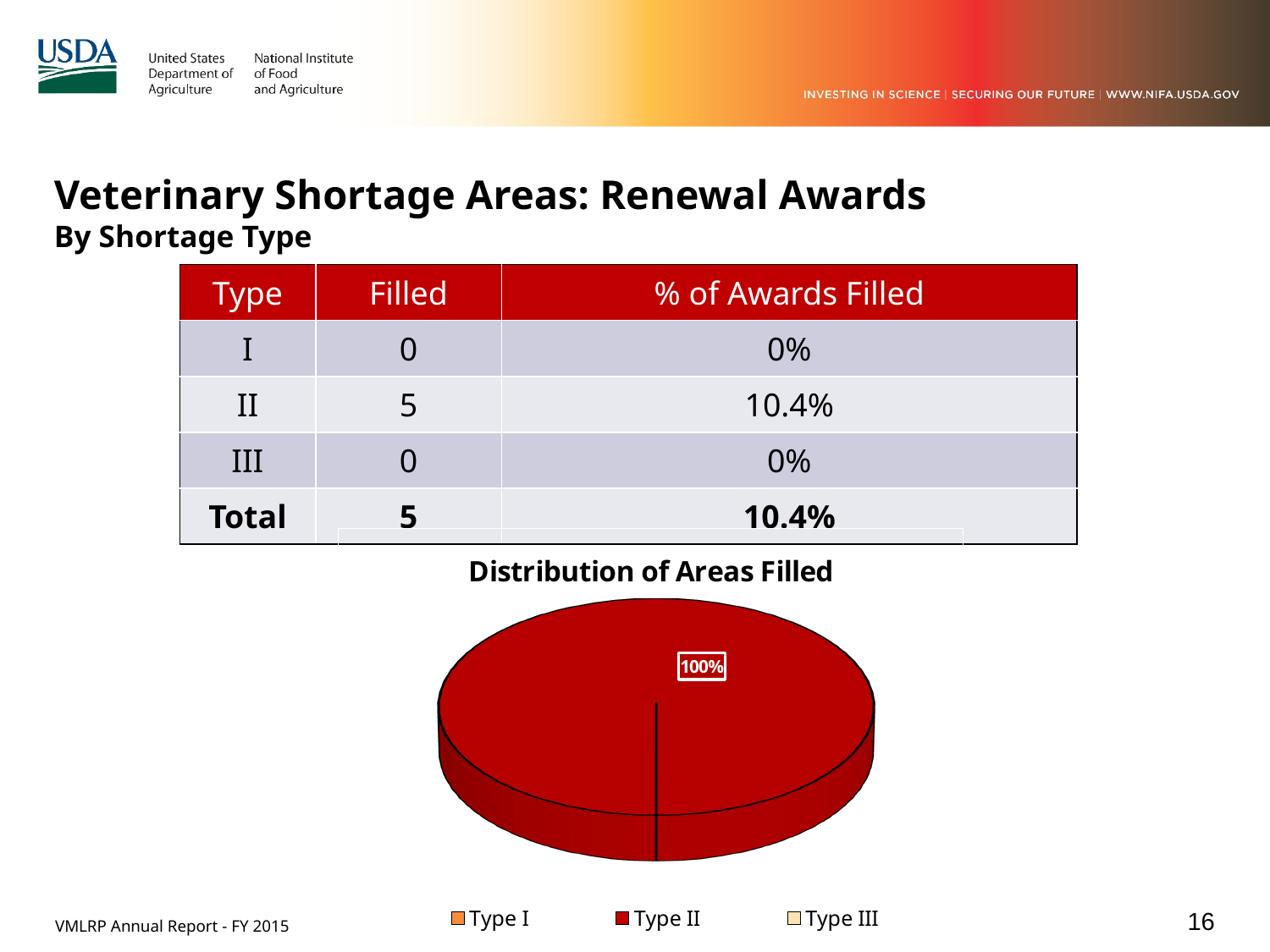
How many entries does the legend of the pie chart list? 3 What colour is the Type II slice in the pie chart? red What share of the pie chart does the labelled slice represent? 100% Which is larger in the pie chart, the share for Type II or the share for Type I? Type II Which shortage type accounts for the entire pie in the "Distribution of Areas Filled" chart? Type II Which legend entries are listed for the pie chart? Type I, Type II, Type III Is the share of the pie for Type II greater or less than 50%? greater What kind of chart is shown under the title "Distribution of Areas Filled"? pie chart What is the title of the chart on the slide? Distribution of Areas Filled